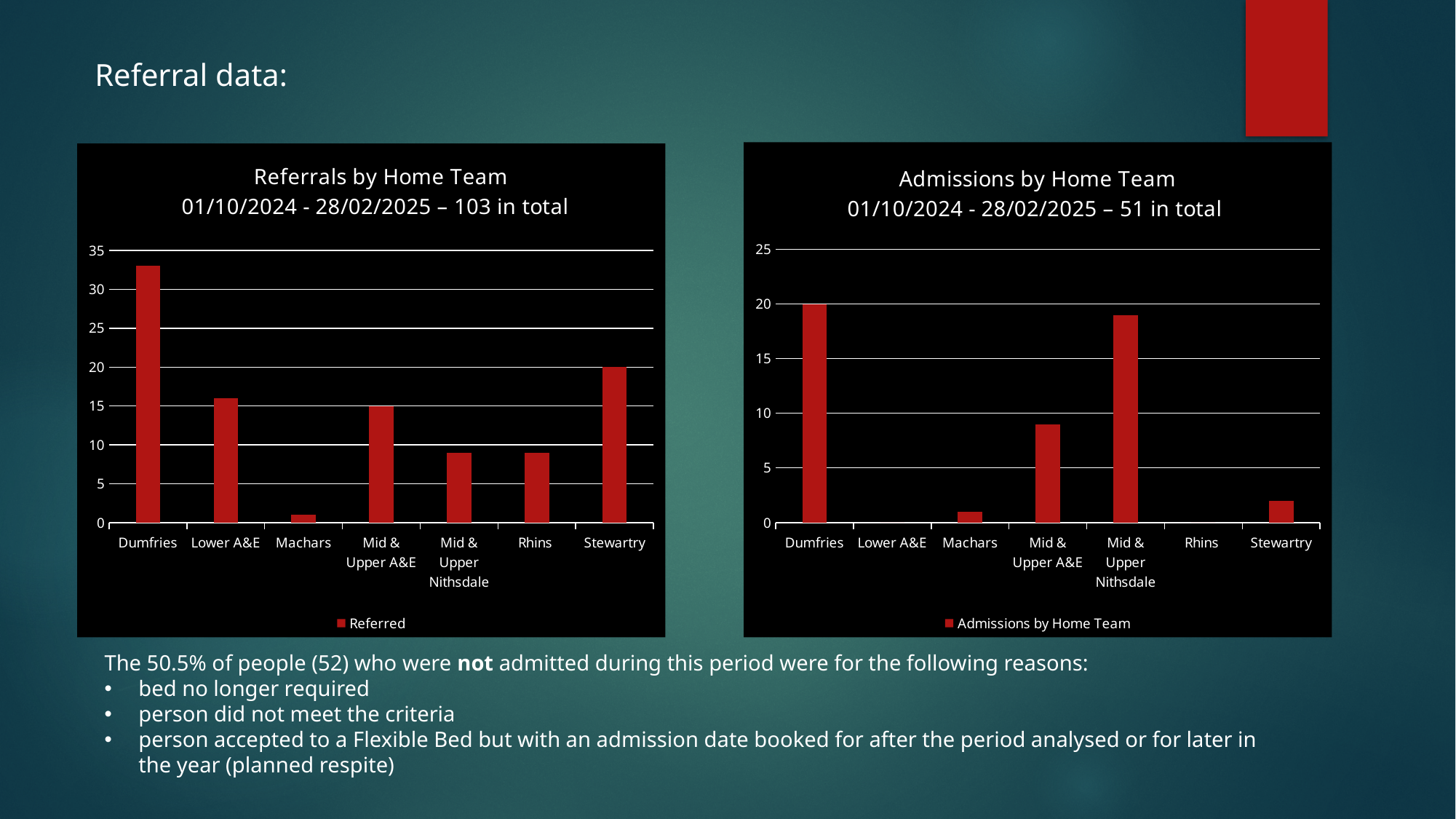
On the Admissions by Home Team chart, is the value for Mid & Upper Nithsdale greater or less than 15? greater How many home teams are shown on the x axis of the Admissions by Home Team chart? 7 On the Admissions by Home Team chart, what is the value for Dumfries? 20 On the Referrals by Home Team chart, is the value for Machars greater or less than 5? less On the Referrals by Home Team chart, which home team has the highest number of referrals? Dumfries On the Admissions by Home Team chart, which is larger, the value for Mid & Upper Nithsdale or the value for Mid & Upper A&E? Mid & Upper Nithsdale On the Referrals by Home Team chart, what is the value for Mid & Upper A&E? 15 On the Referrals by Home Team chart, what is the value for Stewartry? 20 On the Referrals by Home Team chart, which home team has the lowest number of referrals? Machars What kind of chart is the Admissions by Home Team chart? bar chart How many series does the legend of the Referrals by Home Team chart list? 1 On the Referrals by Home Team chart, is the value for Dumfries greater or less than 30? greater